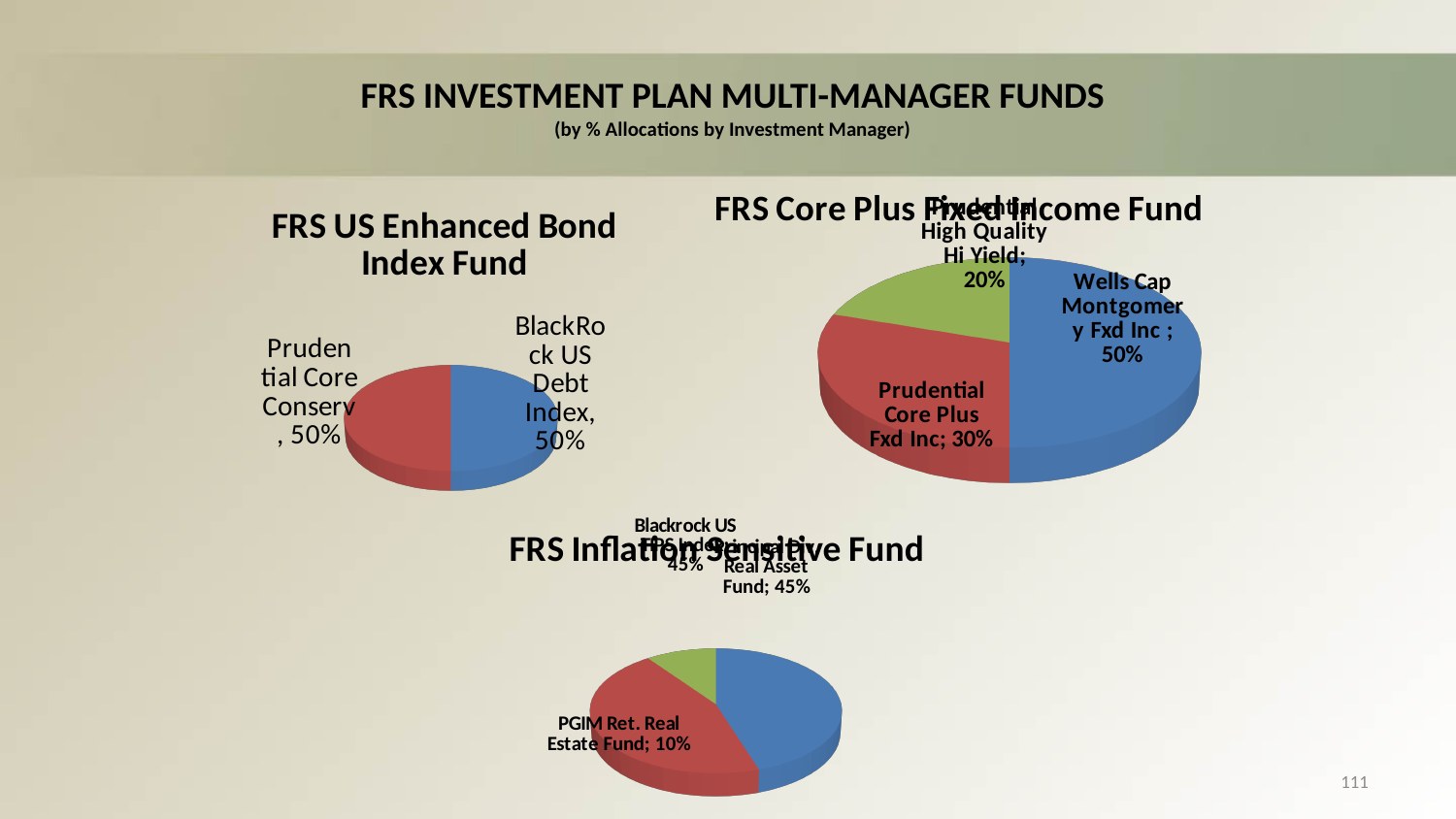
In the FRS US Enhanced Bond Index Fund chart, what share is allocated to BlackRock US Debt Index? 50% In the FRS Inflation Sensitive Fund chart, what share is allocated to PGIM Ret. Real Estate Fund? 10% In the FRS Core Plus Fixed Income Fund chart, which manager has the smallest allocation? Prudential High Quality Hi Yield In the FRS Core Plus Fixed Income Fund chart, what share is allocated to Prudential Core Plus Fxd Inc? 30% In the FRS Core Plus Fixed Income Fund chart, what share is allocated to Prudential High Quality Hi Yield? 20% In the FRS Core Plus Fixed Income Fund chart, how many percentage points larger is the Wells Cap Montgomery Fxd Inc allocation than the Prudential Core Plus Fxd Inc allocation? 20 percentage points In the FRS Core Plus Fixed Income Fund chart, what share is allocated to Wells Cap Montgomery Fxd Inc? 50% In the FRS Core Plus Fixed Income Fund chart, which manager has the largest allocation? Wells Cap Montgomery Fxd Inc In the FRS US Enhanced Bond Index Fund chart, how many slices does the pie have? 2 What kind of chart is the FRS US Enhanced Bond Index Fund chart? Pie chart In the FRS US Enhanced Bond Index Fund chart, what share is allocated to Prudential Core Conserv? 50% In the FRS Core Plus Fixed Income Fund chart, how many slices does the pie have? 3